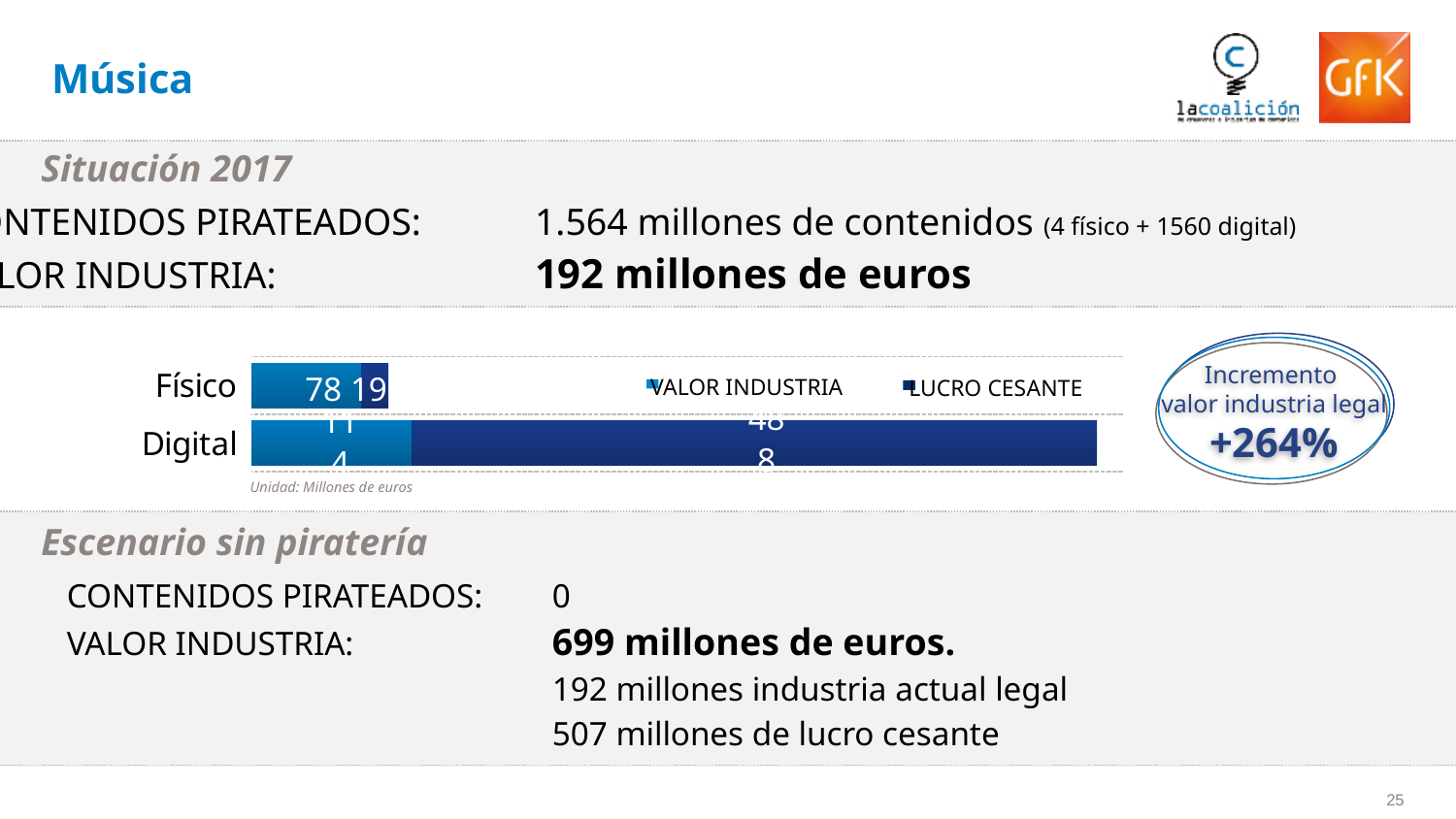
For Físico, which is larger: VALOR INDUSTRIA or LUCRO CESANTE? VALOR INDUSTRIA What is the VALOR INDUSTRIA value for Físico? 78 What is the LUCRO CESANTE value for Físico? 19 How many categories are plotted in the chart? 2 What is the total of the stacked bar for Físico? 97 What are the two series named in the chart legend? VALOR INDUSTRIA and LUCRO CESANTE What unit does the chart note say the values are in? Millones de euros What is the difference between VALOR INDUSTRIA and LUCRO CESANTE for Físico? 59 What kind of chart is shown on the slide? Bar chart How many series does the chart legend list? 2 Which category has the larger LUCRO CESANTE segment, Físico or Digital? Digital Which category has the longer stacked bar overall, Físico or Digital? Digital